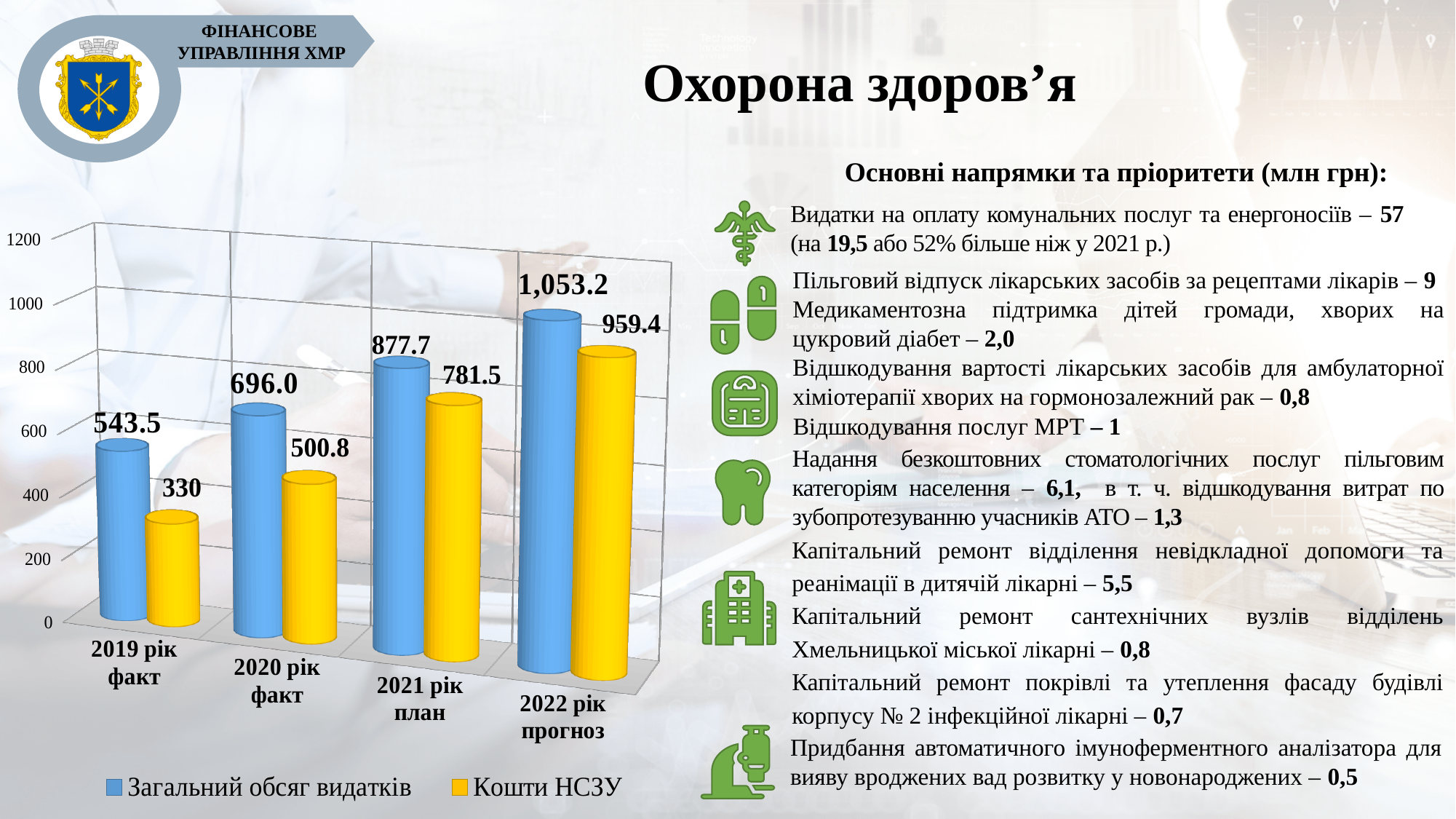
What is the difference between Загальний обсяг видатків and Кошти НСЗУ for 2022 рік прогноз? 93.8 How many series does the chart legend list? 2 What is the difference between Загальний обсяг видатків and Кошти НСЗУ for 2019 рік факт? 213.5 How many categories are shown on the x axis of the chart? 4 What is the value of Кошти НСЗУ for 2019 рік факт? 330 Which category has the highest value for Кошти НСЗУ? 2022 рік прогноз Do the values of Загальний обсяг видатків rise or fall from 2019 рік факт to 2022 рік прогноз? rise What is the value of Загальний обсяг видатків for 2020 рік факт? 696.0 Which is larger: Кошти НСЗУ for 2021 рік план or Загальний обсяг видатків for 2020 рік факт? Кошти НСЗУ for 2021 рік план What is the value of Кошти НСЗУ for 2021 рік план? 781.5 What is the value of Загальний обсяг видатків for 2022 рік прогноз? 1,053.2 Which category has the lowest value for Загальний обсяг видатків? 2019 рік факт